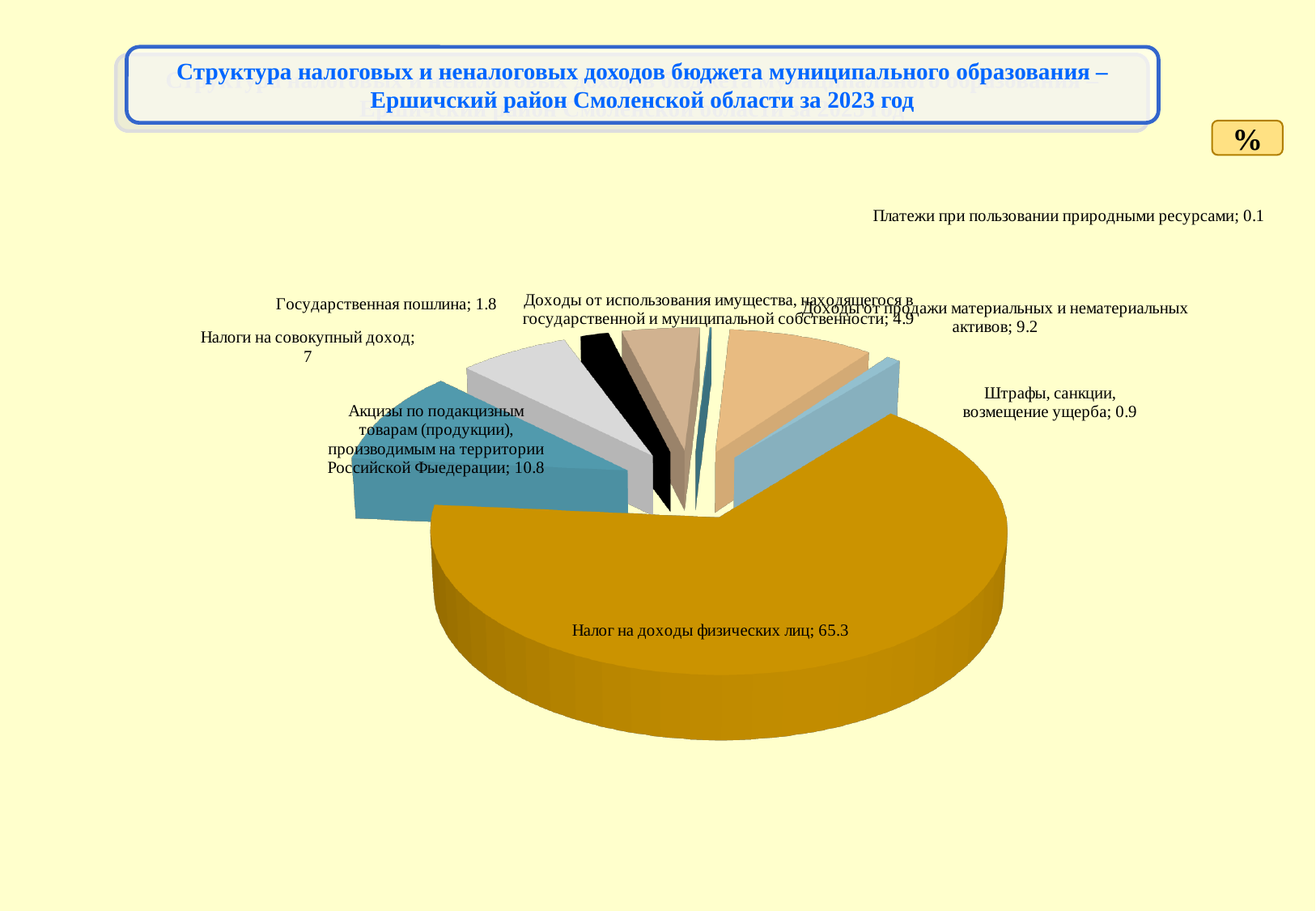
Which category has the largest slice of the pie? Налог на доходы физических лиц What is the value for Налоги на совокупный доход? 7 What kind of chart is shown on the slide? pie chart What is the value for Штрафы, санкции, возмещение ущерба? 0.9 What is the value for Акцизы по подакцизным товарам (продукции), производимым на территории Российской Фыедерации? 10.8 How many categories are shown in the pie chart? 8 Which category has the smallest slice of the pie? Платежи при пользовании природными ресурсами What is the value for Доходы от продажи материальных и нематериальных активов? 9.2 What is the difference between the values for Акцизы по подакцизным товарам and Налоги на совокупный доход? 3.8 For which year does the chart title say the budget revenue structure is shown? 2023 What is the value for Налог на доходы физических лиц? 65.3 Which is larger: Государственная пошлина or Доходы от использования имущества, находящегося в государственной и муниципальной собственности? Доходы от использования имущества, находящегося в государственной и муниципальной собственности